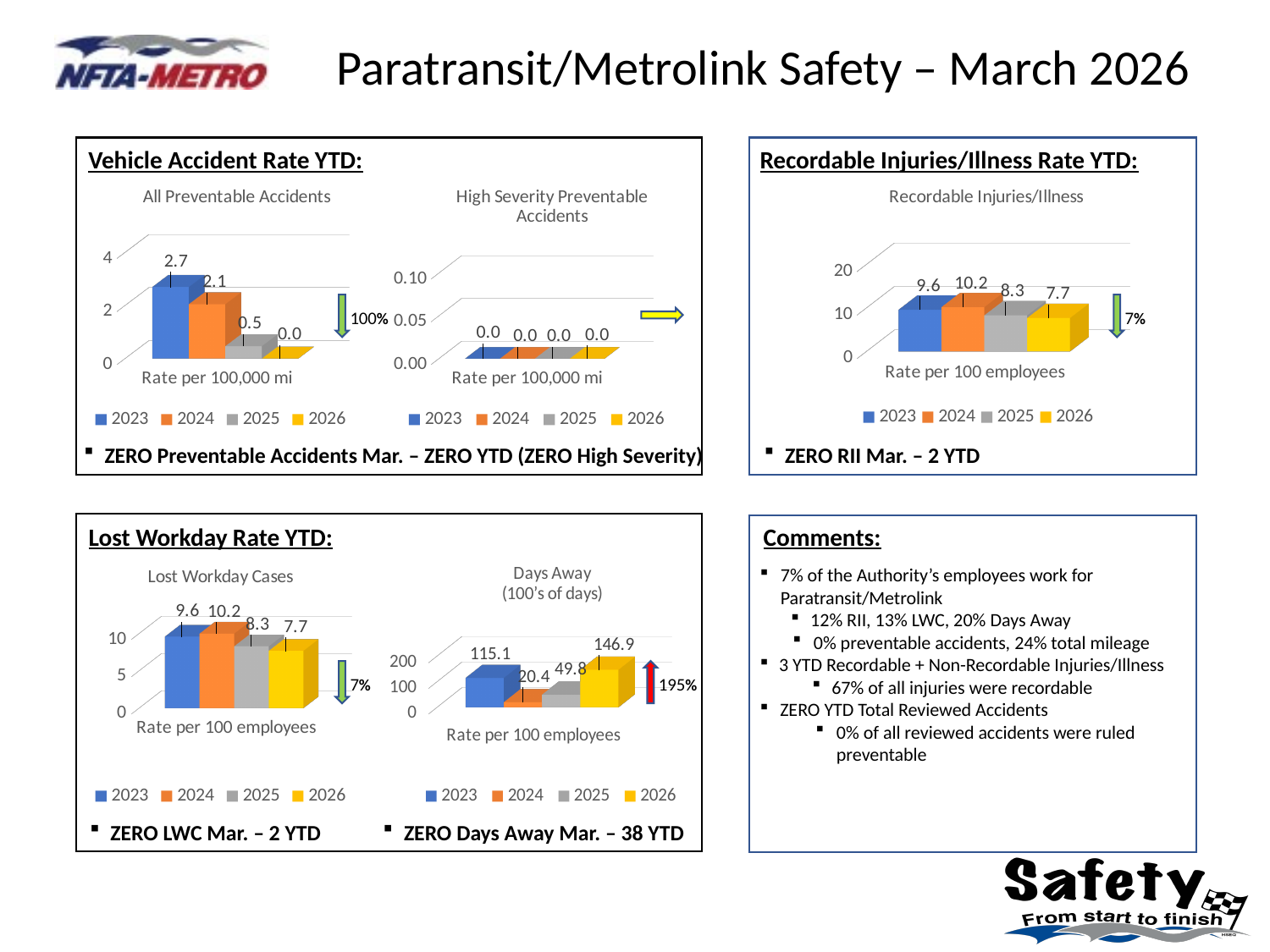
In the "Recordable Injuries/Illness" chart, is the value for 2024 greater or less than 10? greater In the "All Preventable Accidents" chart, which year has the highest value? 2023 In the "Lost Workday Cases" chart, what is the difference between the 2024 and 2026 values? 2.5 In the "Days Away (100's of days)" chart, which is larger, the value for 2023 or the value for 2025? 2023 In the "Recordable Injuries/Illness" chart, what is the value for 2024? 10.2 How many series does the legend of the "Lost Workday Cases" chart list? 4 In the "Days Away (100's of days)" chart, what is the value for 2024? 20.4 In the "All Preventable Accidents" chart, what is the difference between the 2023 and 2024 values? 0.6 In the "Days Away (100's of days)" chart, which year has the highest value? 2026 In the "All Preventable Accidents" chart, what is the value for 2023? 2.7 In the "Recordable Injuries/Illness" chart, which year has the lowest value? 2026 In the "High Severity Preventable Accidents" chart, what is the value for 2026? 0.0